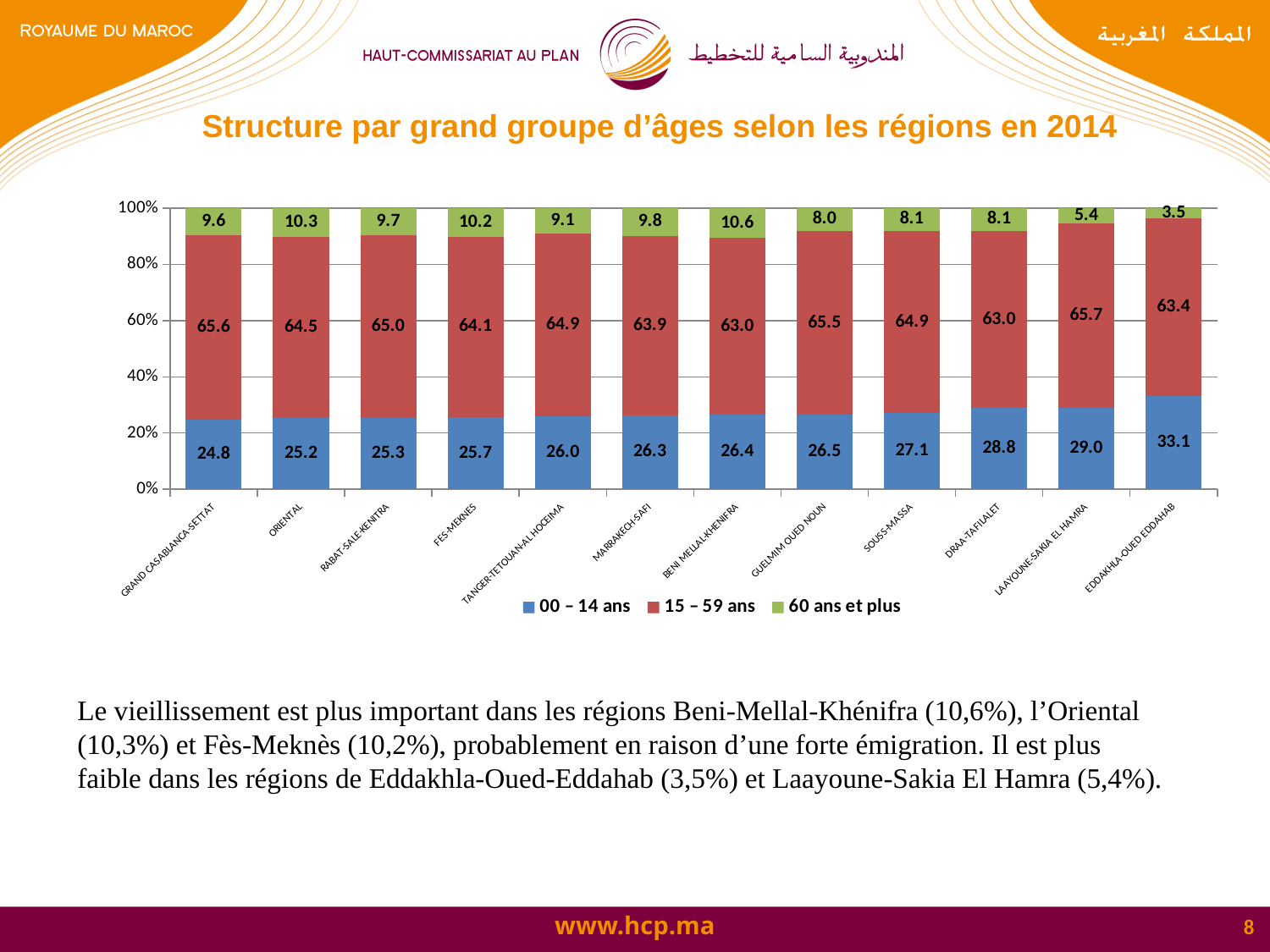
What is the value for the 15 – 59 ans series in LAAYOUNE-SAKIA EL HAMRA? 65.7 What is the difference between the 00 – 14 ans values for EDDAKHLA-OUED EDDAHAB and GRAND CASABLANCA-SETTAT? 8.3 Which region has the lowest value for the 60 ans et plus series? EDDAKHLA-OUED EDDAHAB How many regions are shown on the x axis? 12 Do the values for the 00 – 14 ans series rise or fall from left to right along the x axis? Rise What is the value for the 00 – 14 ans series in GRAND CASABLANCA-SETTAT? 24.8 How many series does the legend list? 3 Which region has the highest value for the 60 ans et plus series? BENI MELLAL-KHENIFRA What kind of chart is shown on the slide? Stacked bar chart Which region has the highest value for the 00 – 14 ans series? EDDAKHLA-OUED EDDAHAB What is the value for the 60 ans et plus series in ORIENTAL? 10.3 Which is larger, the 60 ans et plus value for FES-MEKNES or for MARRAKECH-SAFI? FES-MEKNES